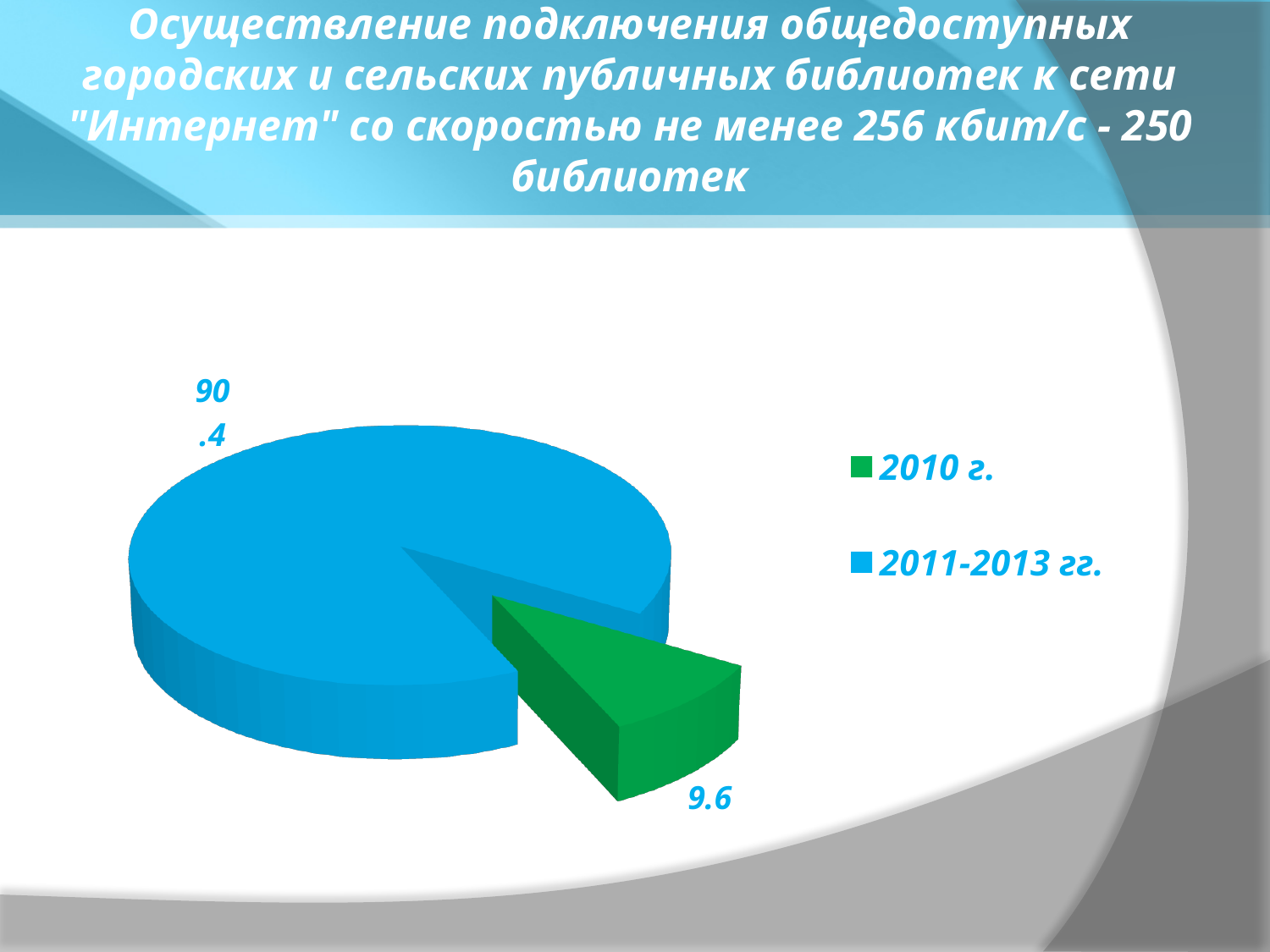
What colour is the 2010 г. slice? green What is the total of the two slice values? 100 How many slices does the pie chart have? 2 How many entries does the legend list? 2 Which slice is the largest? 2011-2013 гг. What kind of chart is shown on the slide? pie chart Which is larger, the value for 2010 г. or the value for 2011-2013 гг.? 2011-2013 гг. What value is shown for the 2010 г. slice? 9.6 What value is shown for the 2011-2013 гг. slice? 90.4 What colour is the 2011-2013 гг. slice? blue Which slice is the smallest? 2010 г. What is the difference between the 2011-2013 гг. value and the 2010 г. value? 80.8